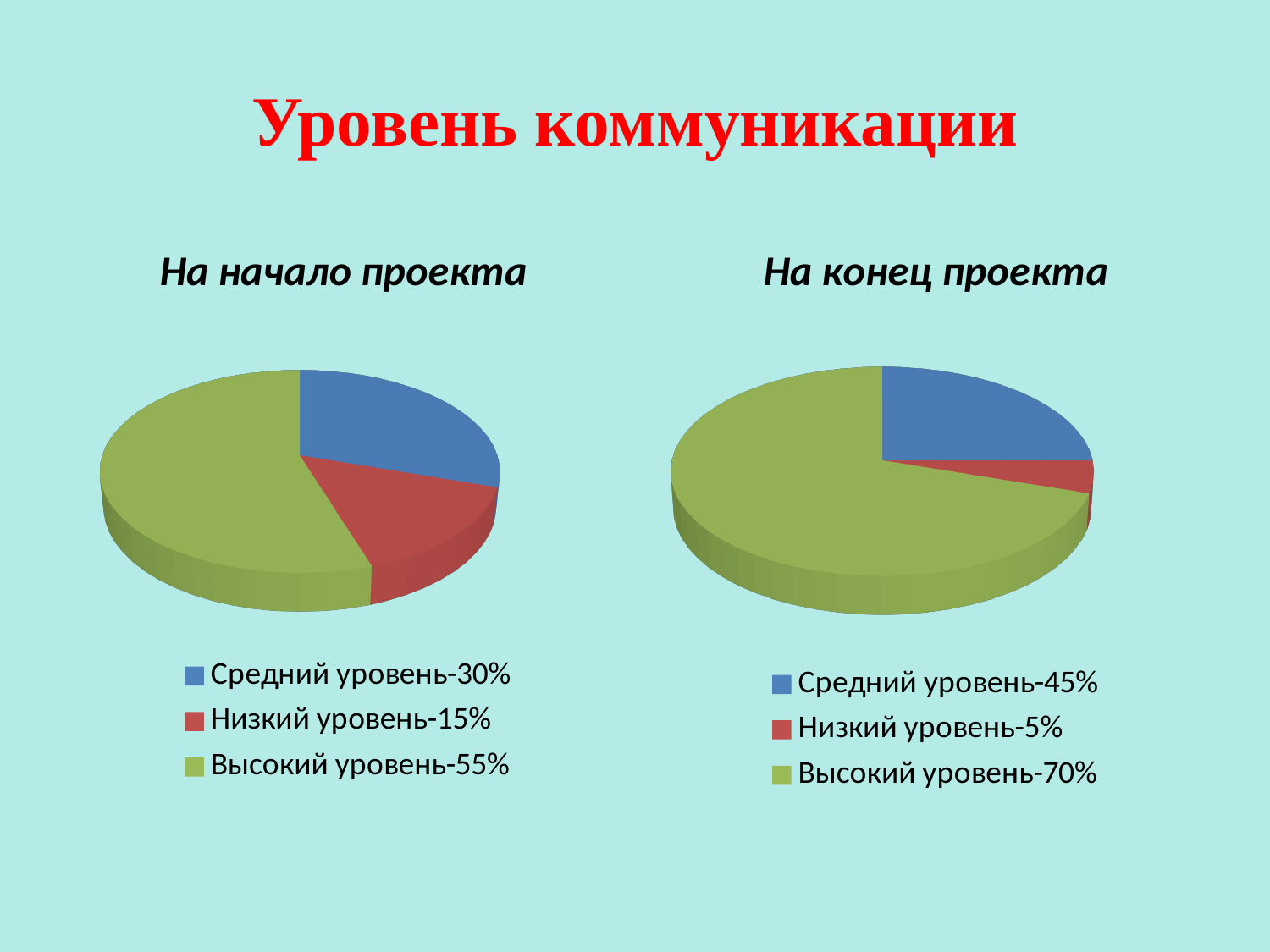
In the chart titled "На конец проекта", what is the difference between the shares of "Высокий уровень" and "Средний уровень"? 25% In the chart titled "На начало проекта", what is the difference between the shares of "Средний уровень" and "Низкий уровень"? 15% In the chart titled "На начало проекта", which category has the largest slice? Высокий уровень In the chart titled "На конец проекта", what share does "Низкий уровень" have? 5% In the chart titled "На конец проекта", which category has the smallest slice? Низкий уровень What kind of chart is the chart titled "На начало проекта"? Pie chart Which is larger: "Высокий уровень" in the chart titled "На начало проекта" or "Высокий уровень" in the chart titled "На конец проекта"? На конец проекта In the chart titled "На конец проекта", what share does "Средний уровень" have? 45% In the chart titled "На начало проекта", what colour is the slice for "Низкий уровень"? Red In the chart titled "На начало проекта", what share does "Высокий уровень" have? 55% What is the title of the slide containing the two pie charts? Уровень коммуникации How many categories does the chart titled "На конец проекта" show? 3